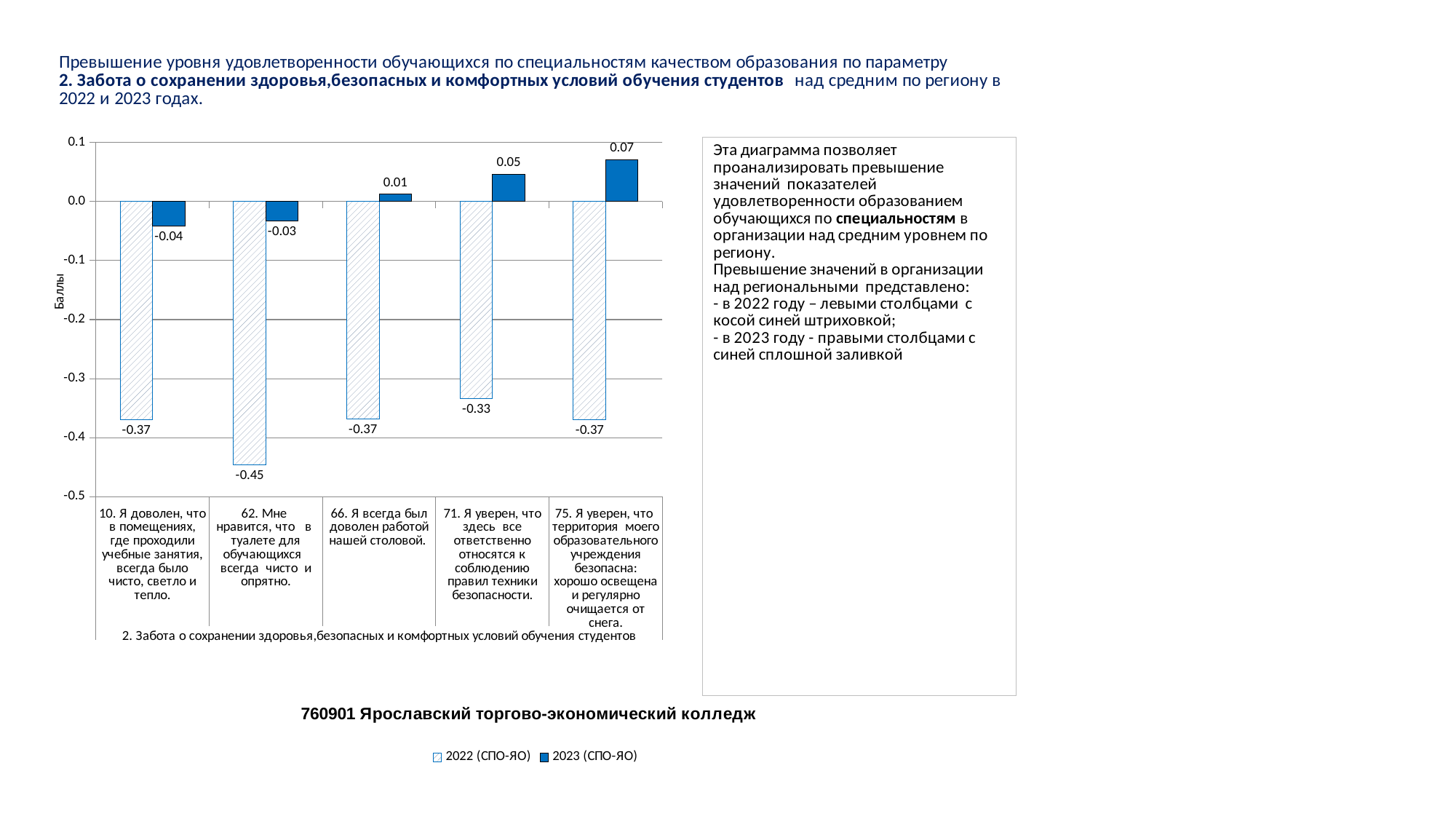
Do the 2023 (СПО-ЯО) values rise or fall from left to right along the x axis? rise What is the label of the vertical axis? Баллы For statement 10 ("Я доволен, что в помещениях, где проходили учебные занятия, всегда было чисто, светло и тепло"), which series has the larger value, 2022 (СПО-ЯО) or 2023 (СПО-ЯО)? 2023 (СПО-ЯО) How many series does the legend list? 2 What is the difference between the 2023 and 2022 values for statement 71 ("Я уверен, что здесь все ответственно относятся к соблюдению правил техники безопасности")? 0.38 What is the 2023 (СПО-ЯО) value for statement 66 ("Я всегда был доволен работой нашей столовой")? 0.01 What is the 2023 (СПО-ЯО) value for statement 75 ("Я уверен, что территория моего образовательного учреждения безопасна")? 0.07 How many categories (statements) are shown on the x axis? 5 Which statement has the highest 2023 (СПО-ЯО) value? 75. Я уверен, что территория моего образовательного учреждения безопасна: хорошо освещена и регулярно очищается от снега. What is the 2022 (СПО-ЯО) value for statement 62 ("Мне нравится, что в туалете для обучающихся всегда чисто и опрятно")? -0.45 What type of chart is shown on the slide? bar chart Which statement has the lowest 2022 (СПО-ЯО) value? 62. Мне нравится, что в туалете для обучающихся всегда чисто и опрятно.